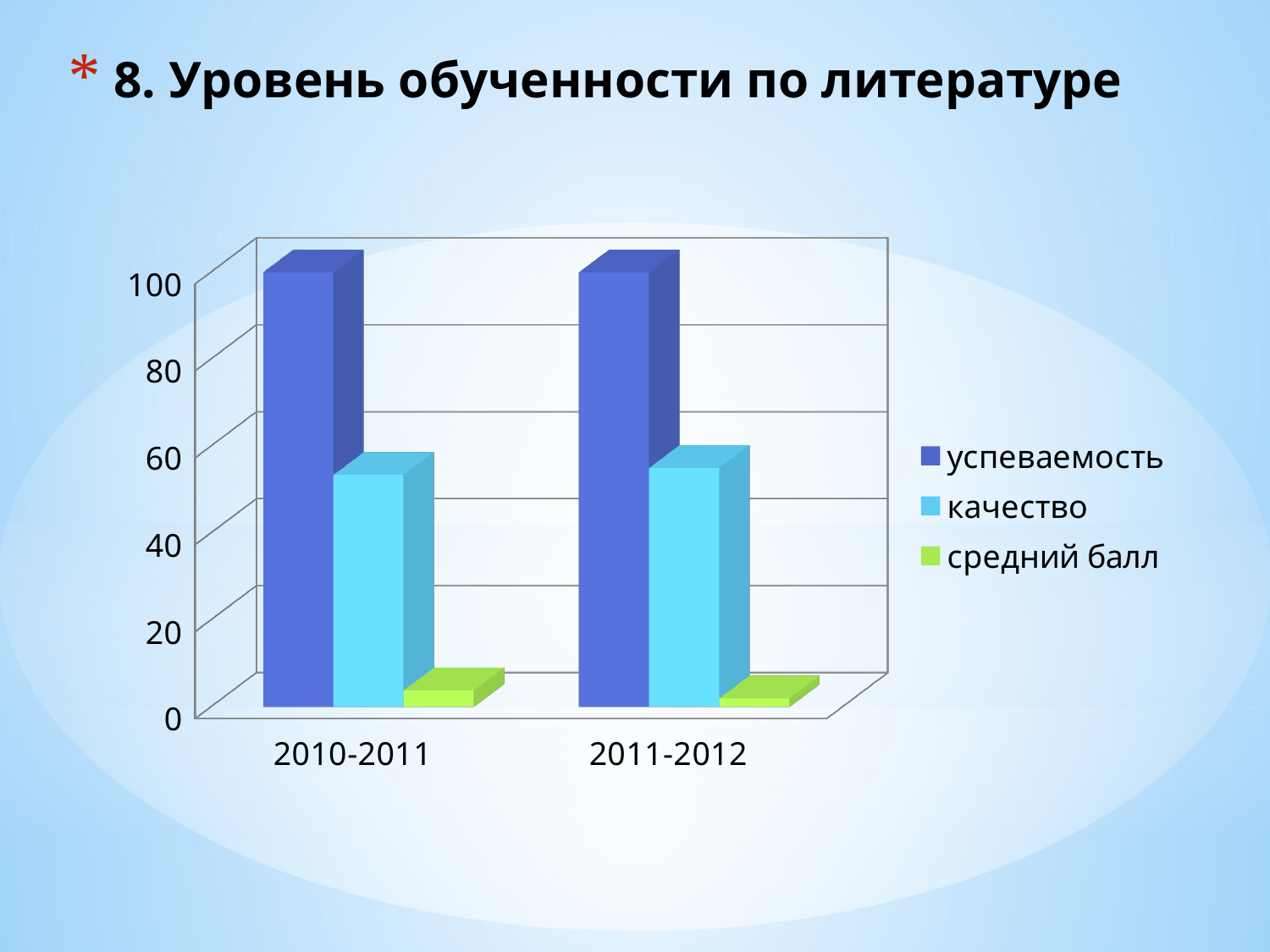
Which is larger for 2011-2012: качество or средний балл? качество Which series has the highest value for 2010-2011? успеваемость How many categories are shown on the x axis? 2 Is the value for качество in 2011-2012 greater or less than 80? less What kind of chart is shown on the slide? bar chart How many series does the legend list? 3 Is the value for успеваемость in 2011-2012 greater or less than 80? greater Which series has the lowest value for 2011-2012? средний балл What is the title of the slide containing the chart? 8. Уровень обученности по литературе Is the value for средний балл in 2010-2011 greater or less than 20? less Which series is shown in green in the legend? средний балл